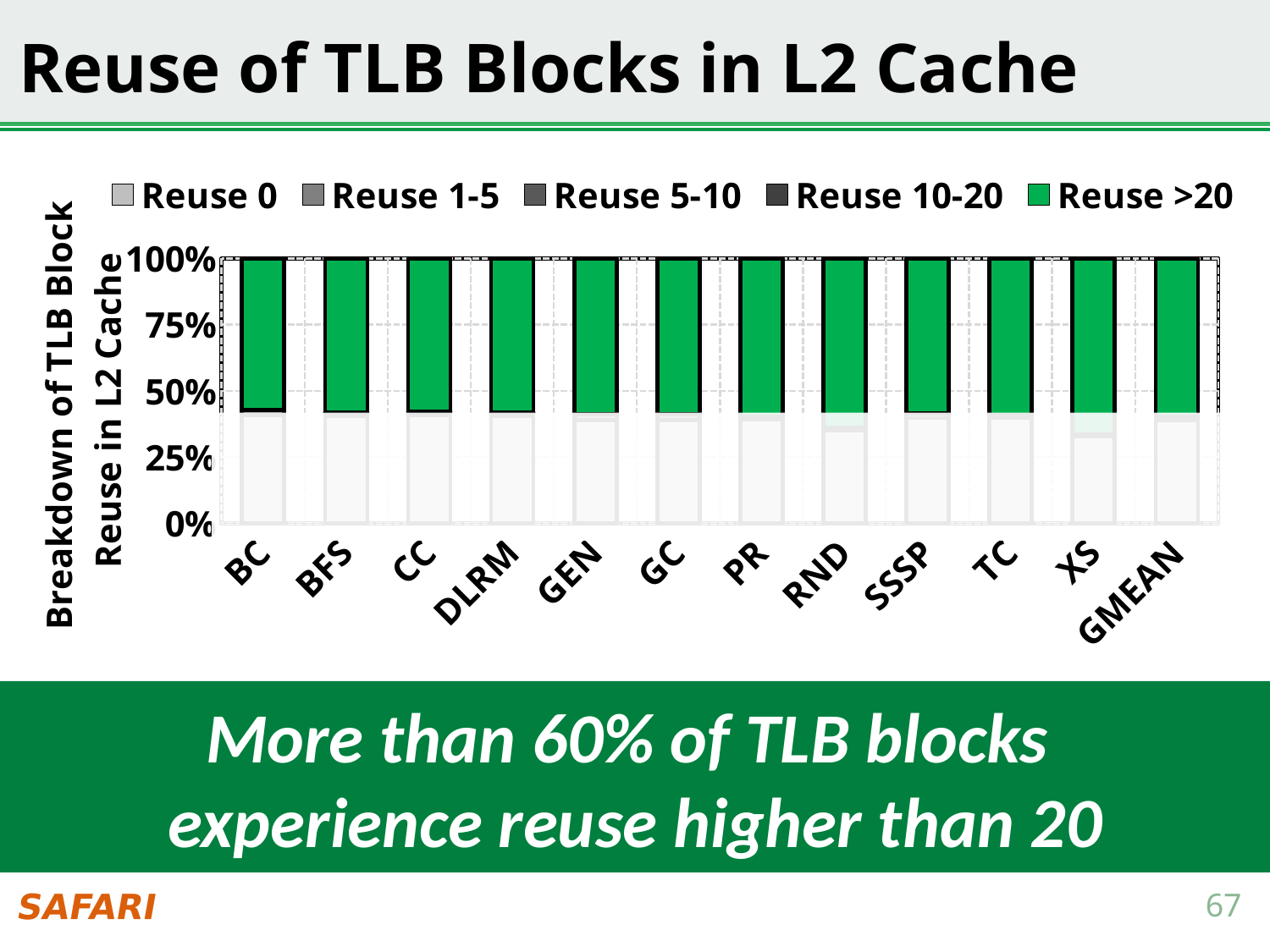
Is the Reuse 0 value for BC greater or less than 50%? less What is the total height of the stacked bar for BC? 100% How many categories are shown along the x axis of the chart? 12 Is the Reuse >20 value for XS greater or less than 50%? greater Is the Reuse >20 value for RND greater or less than 50%? greater What kind of chart is shown on the slide? Stacked bar chart What is the title of the slide containing the chart? Reuse of TLB Blocks in L2 Cache What is the total height of the stacked bar for GMEAN? 100% How many series does the chart's legend list? 5 Which legend entry is shown in green? Reuse >20